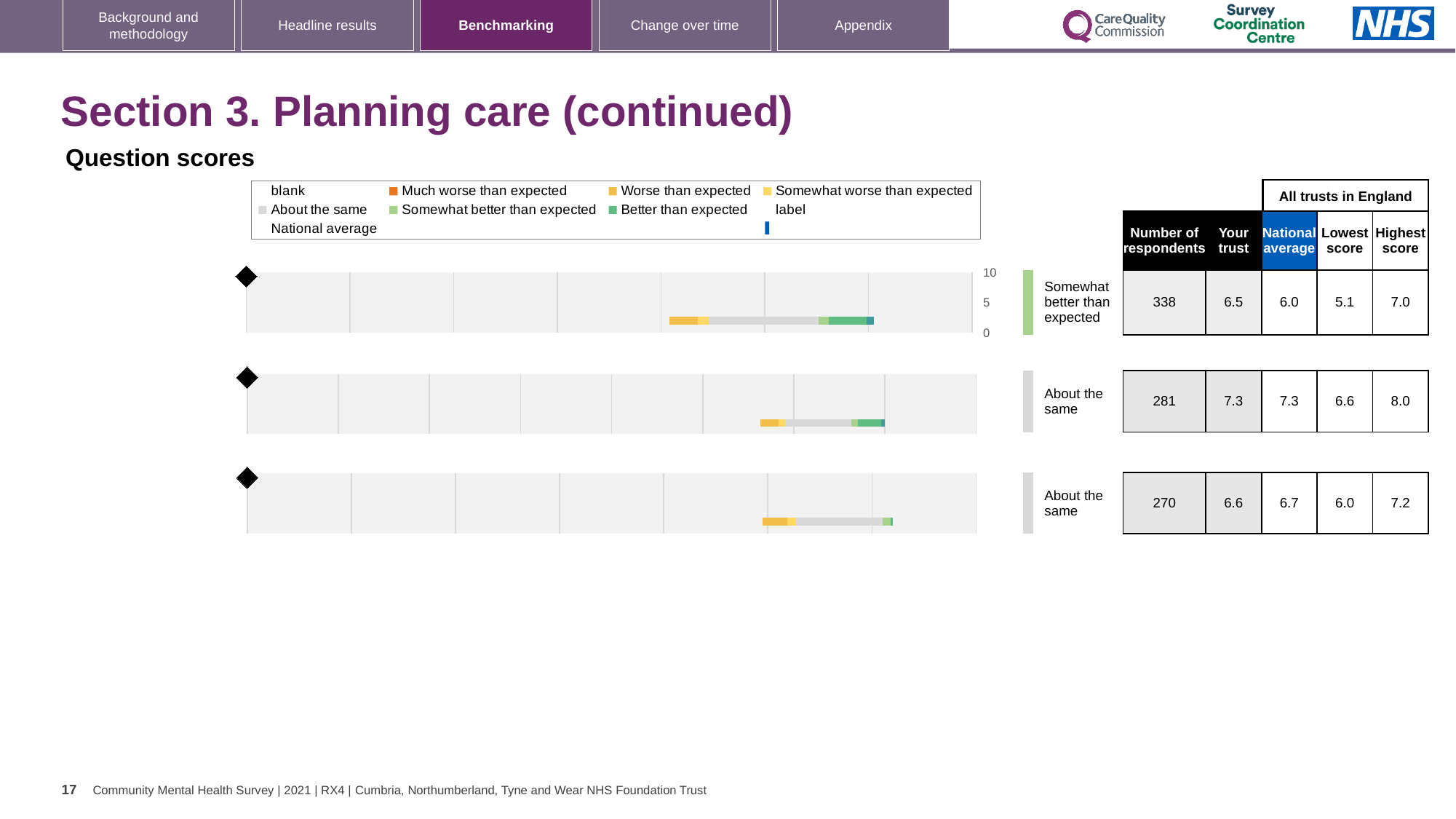
What kind of chart is used for the question scores on this slide? bar chart What benchmark category is shown next to the top chart? Somewhat better than expected For the middle chart, what is the difference between the highest score and the lowest score? 1.4 For the top chart, which is larger: the 'Your trust' score or the national average? Your trust For the middle chart, what is the national average score? 7.3 For the bottom chart, what is the highest score among all trusts in England? 7.2 For the top chart, what is the 'Your trust' score? 6.5 For the top chart, how many respondents are listed? 338 For the top chart, what is the lowest score among all trusts in England? 5.1 How many question score charts are shown on the slide? 3 Which chart (top, middle or bottom) has the highest 'Your trust' score? middle What is the maximum value shown on the score axis of the top chart? 10